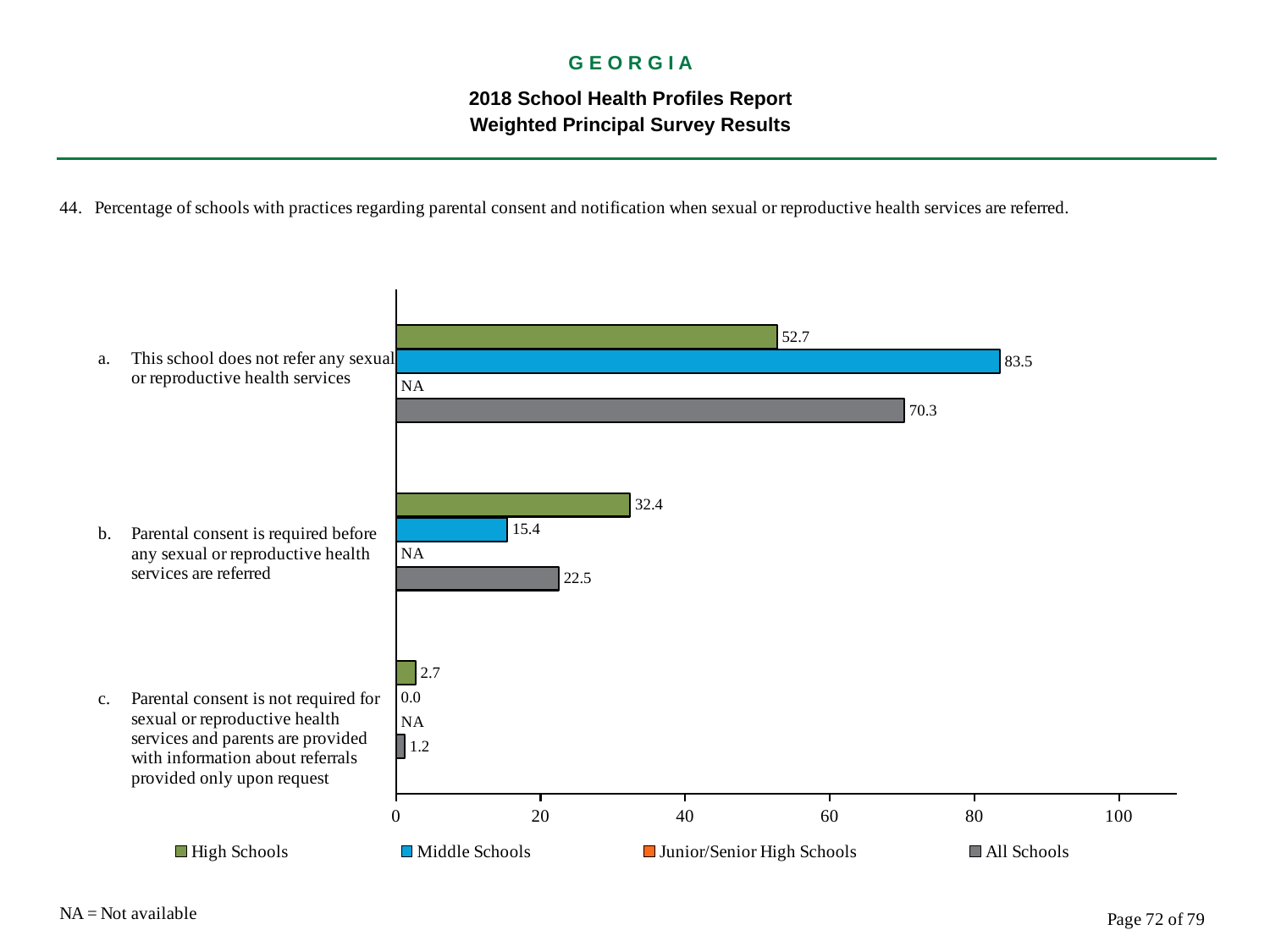
What is the value for High Schools for 'Parental consent is not required for sexual or reproductive health services and parents are provided with information about referrals provided only upon request'? 2.7 What kind of chart is shown on the slide? Bar chart How many series does the legend list? 4 What is the value for Middle Schools for 'This school does not refer any sexual or reproductive health services'? 83.5 Which category has the lowest value for Middle Schools? Parental consent is not required for sexual or reproductive health services and parents are provided with information about referrals provided only upon request How many categories are shown on the chart? 3 For 'Parental consent is required before any sexual or reproductive health services are referred', which is larger: High Schools or Middle Schools? High Schools What is the value for All Schools for 'Parental consent is required before any sexual or reproductive health services are referred'? 22.5 What is the difference between the Middle Schools and High Schools values for 'This school does not refer any sexual or reproductive health services'? 30.8 Which category has the highest value for High Schools? This school does not refer any sexual or reproductive health services Is the All Schools value for 'This school does not refer any sexual or reproductive health services' greater or less than 60? greater What value is shown for Junior/Senior High Schools for 'Parental consent is required before any sexual or reproductive health services are referred'? NA